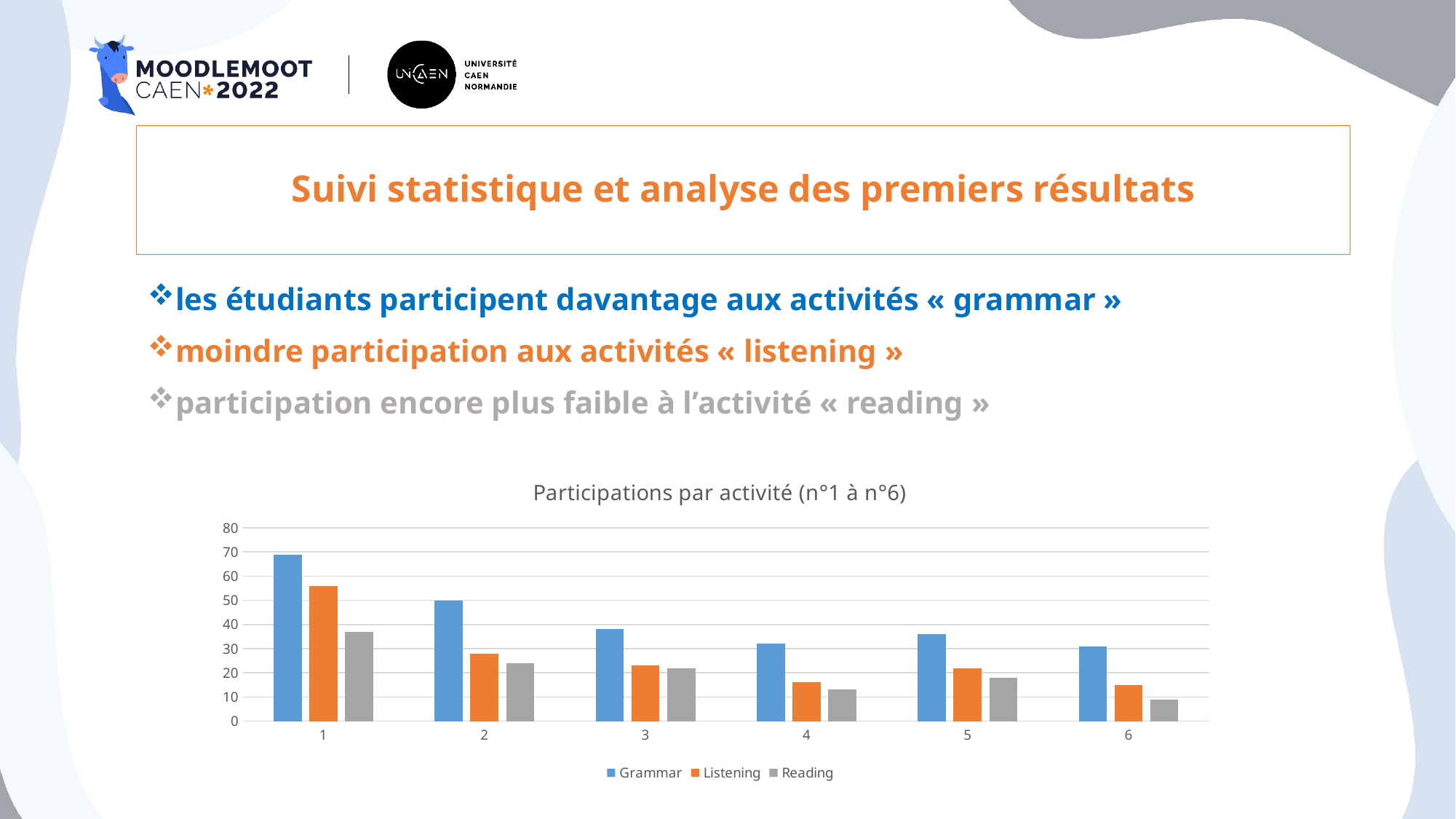
Is the Listening value for activity 4 greater or less than 20? less Which activity number has the highest Grammar value? 1 How many activity categories are shown on the x axis of the chart? 6 Is the Reading value for activity 1 greater or less than 30? greater What is the title of the chart? Participations par activité (n°1 à n°6) Is the Grammar value for activity 1 greater or less than 60? greater How many series does the legend of the chart list? 3 For activity 1, which is larger: the Grammar value or the Listening value? Grammar What kind of chart is shown on the slide? bar chart Do the Listening values rise or fall from activity 1 to activity 4? fall Which activity number has the lowest Reading value? 6 Which colour represents the Listening series in the chart? orange